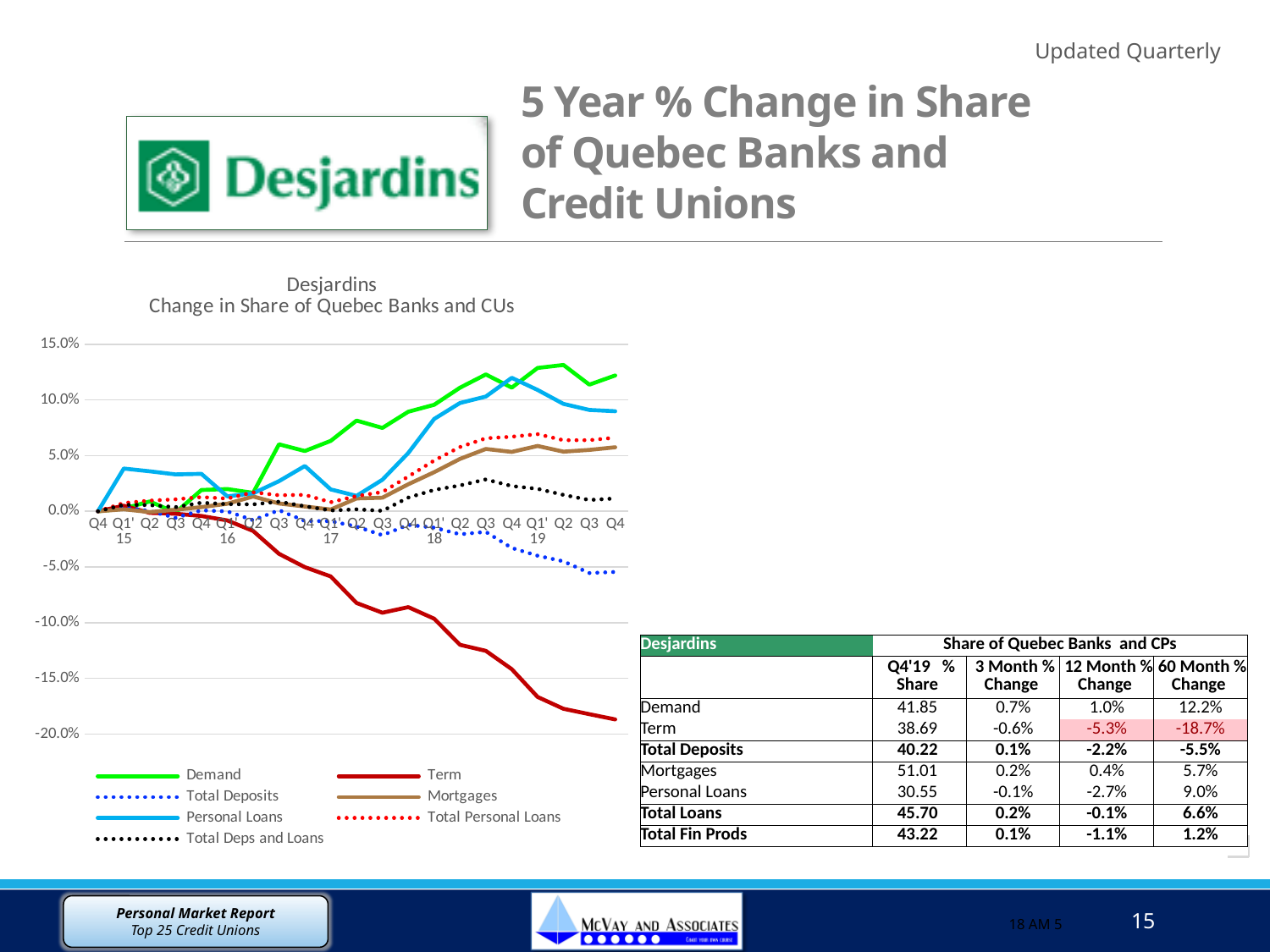
Which series has the lowest value at Q4 19? Term How many quarterly points are plotted along the x axis of the chart? 21 How many series does the chart legend list? 7 Which series has the highest value at Q4 19? Demand Does the Term line rise or fall along the x axis from Q4 15 to Q4 19? fall At Q4 19, which is larger: Personal Loans or Total Deposits? Personal Loans What colour is the Term line in the chart? red Does the Demand line rise or fall overall from Q4 15 to Q4 19? rise What kind of chart is shown on the slide? line chart Is the value for Term at Q4 19 greater or less than -15.0%? less Is the value for Total Deposits at Q4 19 greater or less than 0.0%? less Is the value for Demand at Q4 19 greater or less than 10.0%? greater